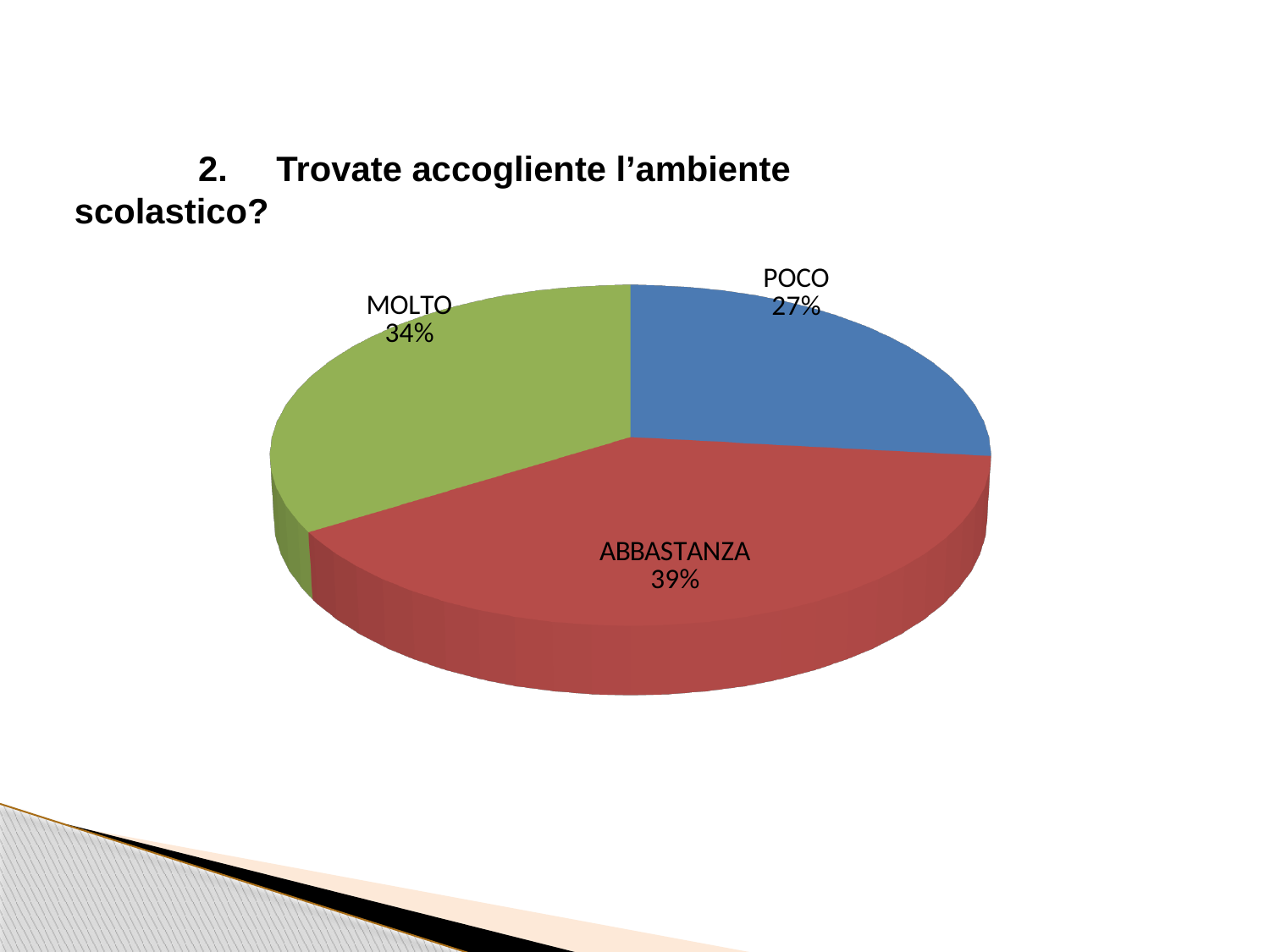
What percentage is shown for MOLTO? 34% Which is larger, the share for MOLTO or the share for POCO? MOLTO What percentage is shown for POCO? 27% What kind of chart is shown on the slide? Pie chart What is the title of the slide above the chart? 2. Trovate accogliente l'ambiente scolastico? What is the difference in percentage points between ABBASTANZA and POCO? 12 What is the difference in percentage points between MOLTO and POCO? 7 How many slices does the pie chart have? 3 Which category has the smallest share of the pie? POCO What percentage is shown for ABBASTANZA? 39% What colour is the ABBASTANZA slice? Red Which category has the largest share of the pie? ABBASTANZA